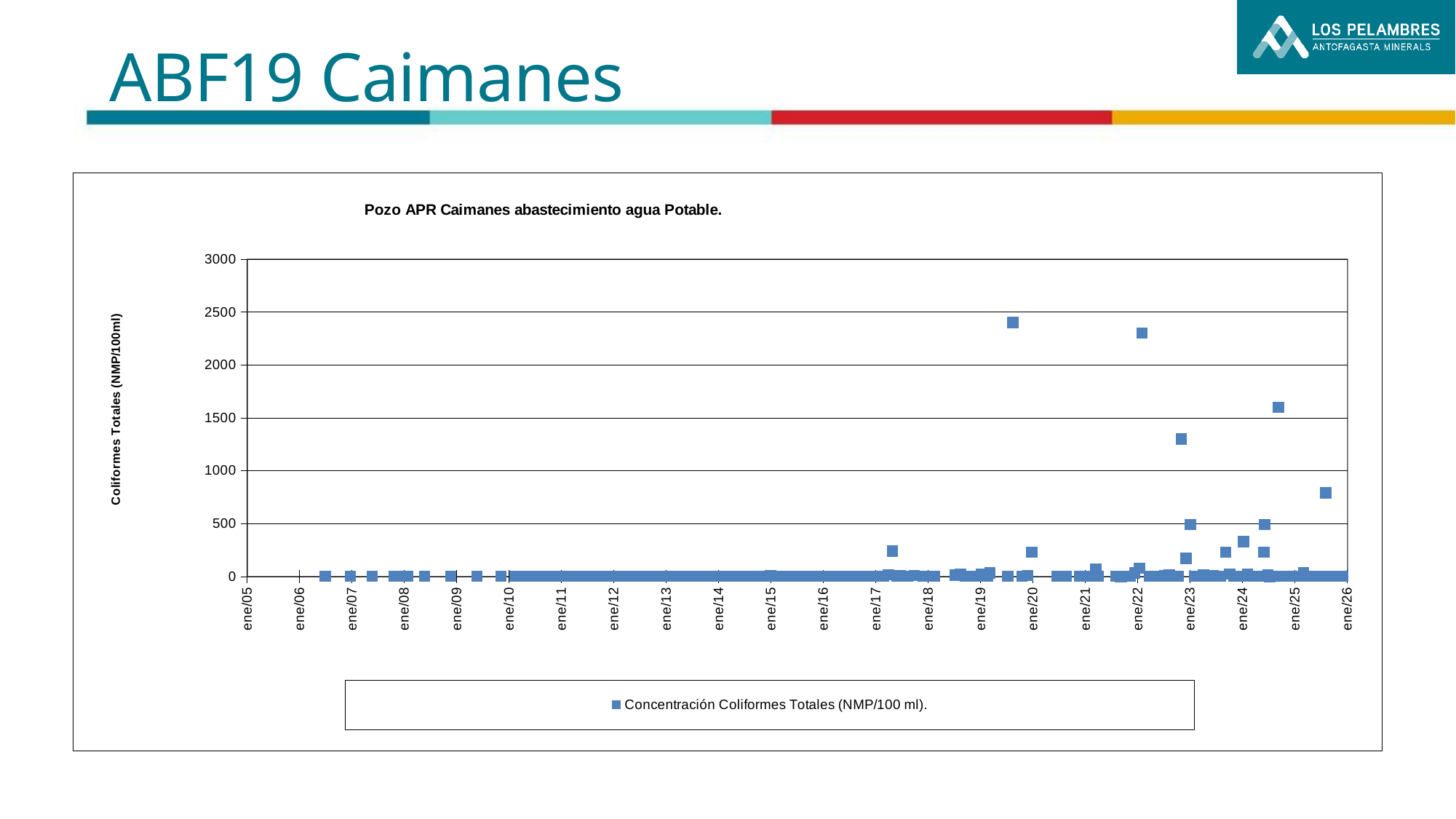
How many labelled tick marks are there on the x axis? 22 What is the highest value shown on the y axis? 3000 How many series does the legend list? 1 Is the value of the isolated high point just before ene/23 greater or less than 1000? greater What is the title of the chart? Pozo APR Caimanes abastecimiento agua Potable. Is the highest plotted value on the chart greater or less than 2500? less What kind of chart is shown on the slide? scatter chart Is the value of the isolated high point just before ene/25 greater or less than 1500? greater What is the label of the y axis? Coliformes Totales (NMP/100ml)